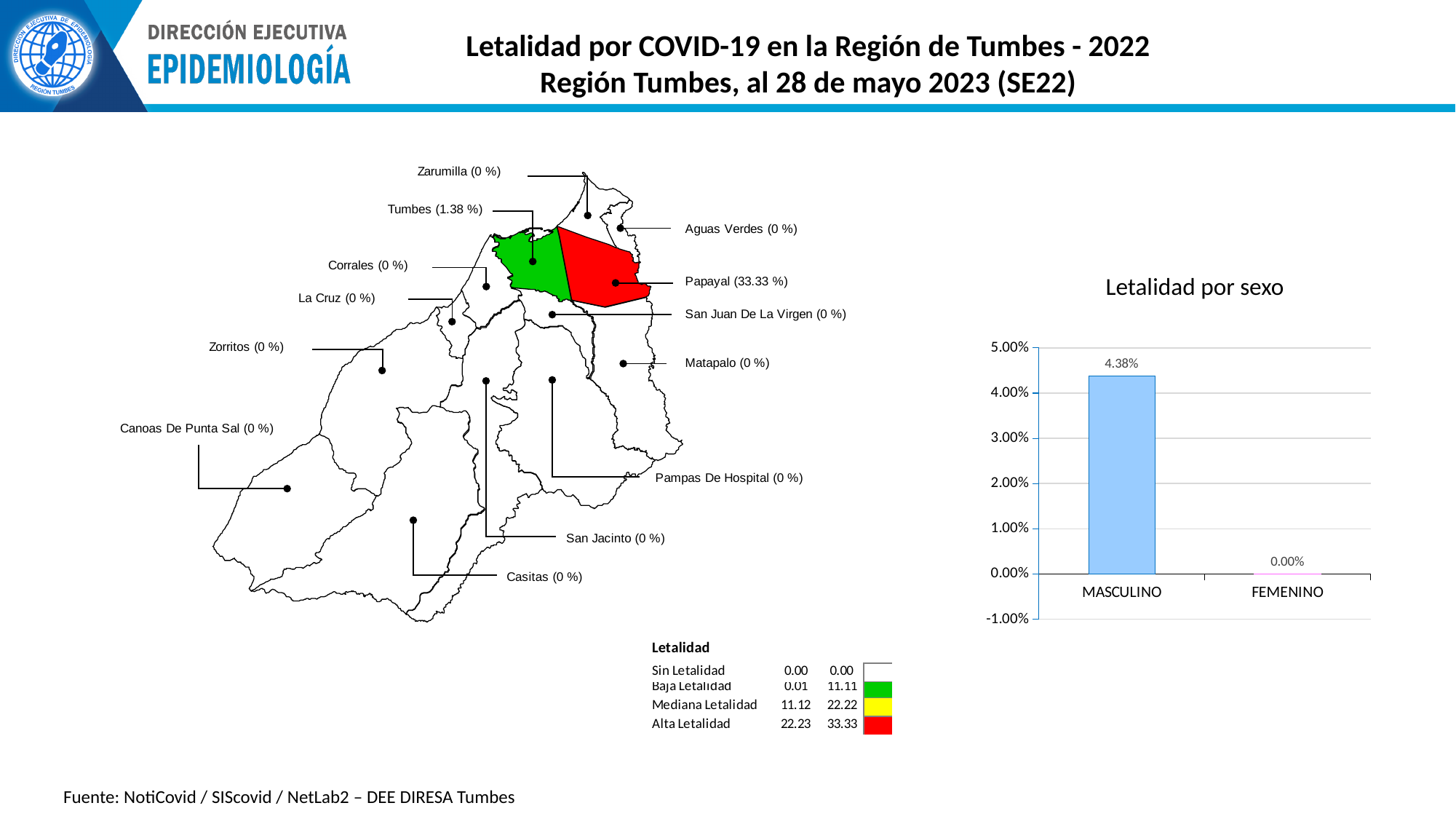
In the 'Letalidad por sexo' chart, what is the value for MASCULINO? 4.38% In the 'Letalidad por sexo' chart, which category has the highest value? MASCULINO On the map, what is the lethality value shown for Tumbes? 1.38 % On the map, which district has the highest lethality value? Papayal (33.33 %) How many categories are shown in the 'Letalidad por sexo' chart? 2 What is the title of the chart on the right side of the slide? Letalidad por sexo In the 'Letalidad por sexo' chart, what is the difference between the MASCULINO and FEMENINO values? 4.38% On the map, which district is shaded red? Papayal In the 'Letalidad por sexo' chart, what is the value for FEMENINO? 0.00% What kind of chart is 'Letalidad por sexo'? bar chart In the 'Letalidad por sexo' chart, which category has the lowest value? FEMENINO In the 'Letalidad por sexo' chart, is the value for MASCULINO greater or less than 4.00%? greater